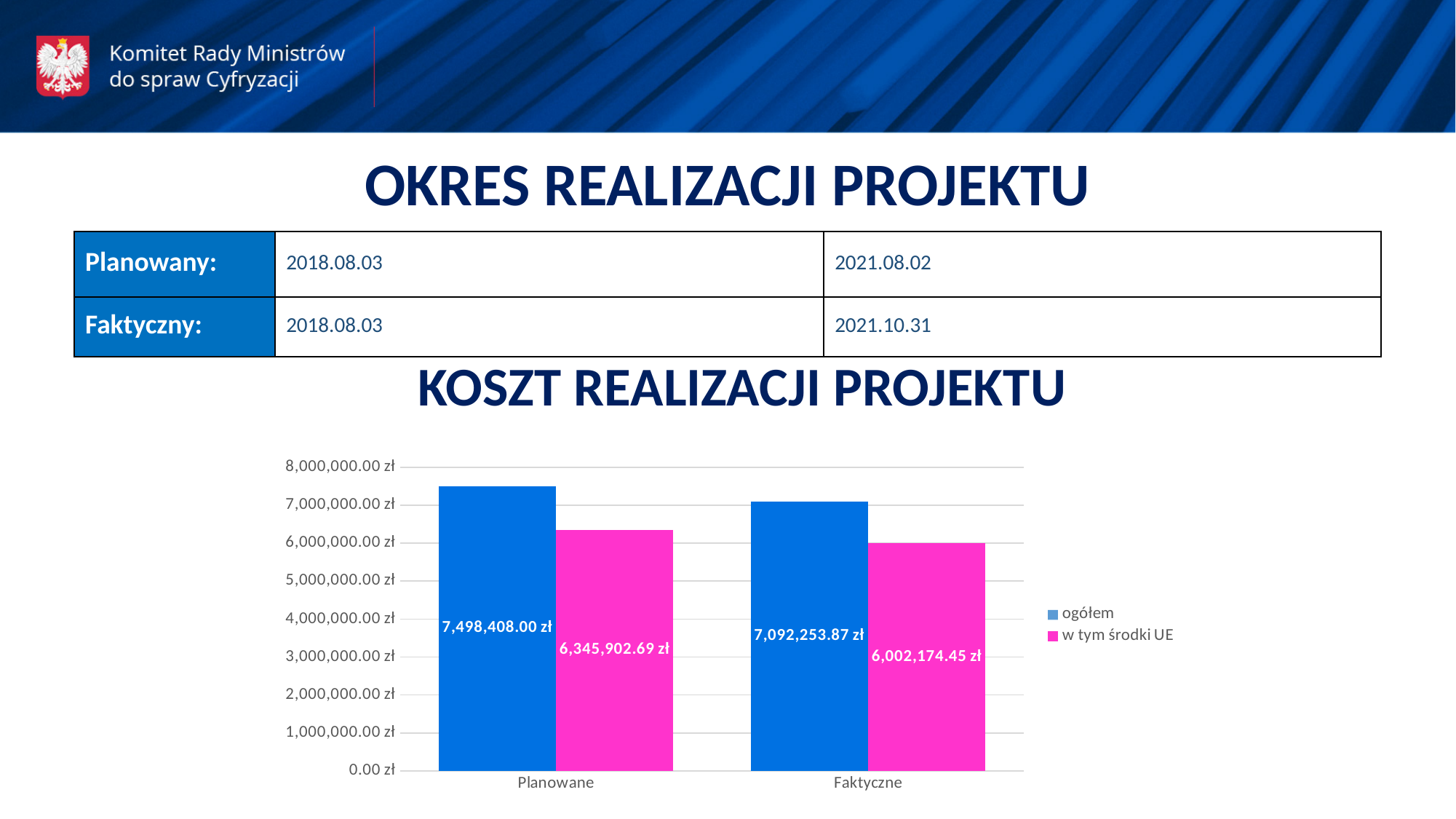
Which bar in the chart has the lowest value? w tym środki UE for Faktyczne Which is larger: the 'w tym środki UE' value for Planowane or for Faktyczne? Planowane What is the value of the 'w tym środki UE' bar for Faktyczne? 6,002,174.45 zł What is the difference between the 'ogółem' and 'w tym środki UE' values for Faktyczne? 1,090,079.42 zł What is the difference between the 'ogółem' values for Planowane and Faktyczne? 406,154.13 zł What is the value of the 'w tym środki UE' bar for Planowane? 6,345,902.69 zł What is the value of the 'ogółem' bar for Planowane? 7,498,408.00 zł Which bar in the chart has the highest value? ogółem for Planowane What is the value of the 'ogółem' bar for Faktyczne? 7,092,253.87 zł What type of chart is shown under 'KOSZT REALIZACJI PROJEKTU'? bar chart How many series does the chart legend list? 2 How many categories are shown on the x axis of the chart? 2